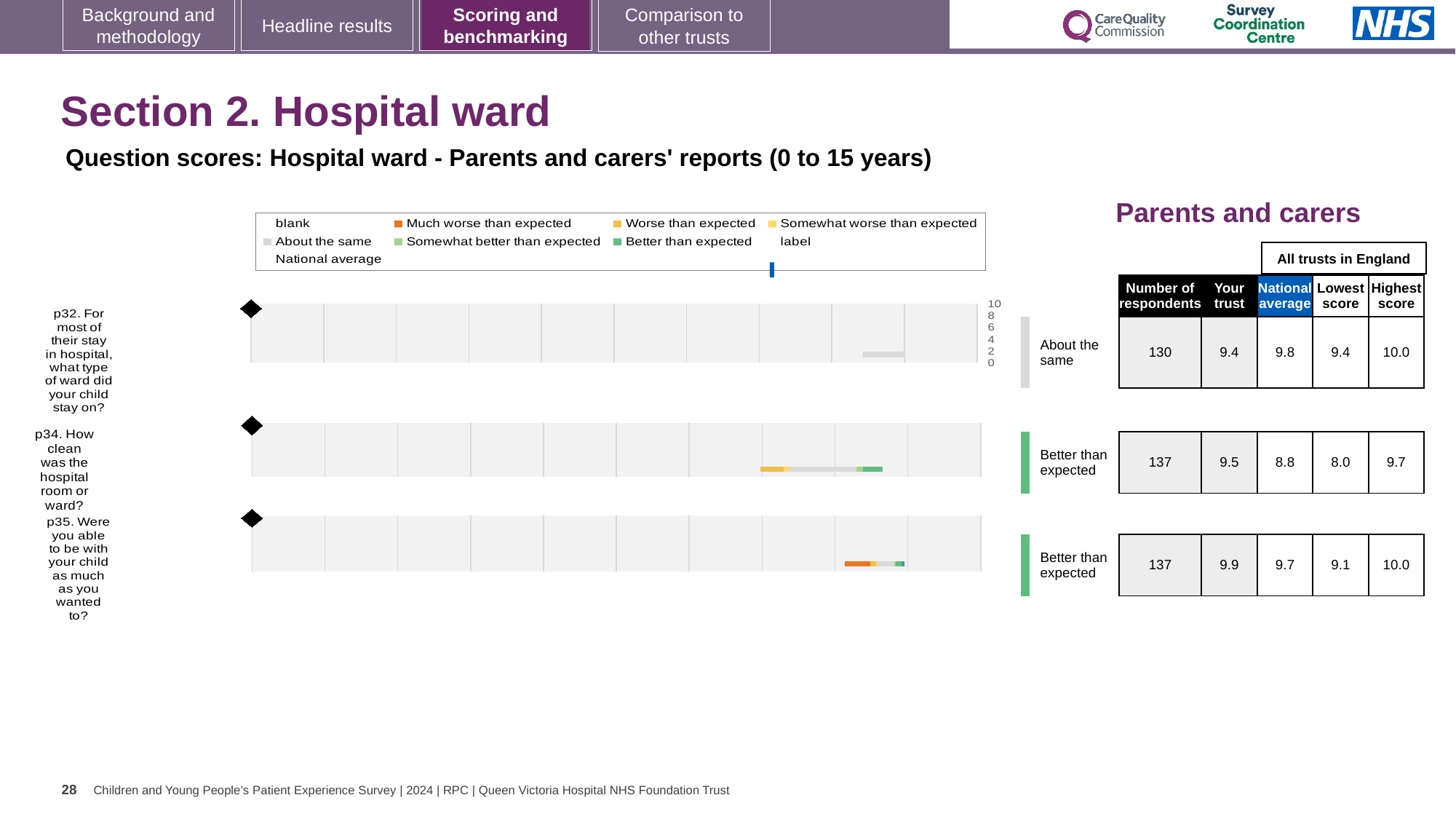
How many questions (p32, p34, p35) are plotted as separate bars on the slide? 3 How many entries does the chart legend list? 9 What is the difference between the 'Your trust' score and the national average for p34? 0.7 What is the highest value shown on the chart's score axis? 10 In the benchmark table, what is the national average for p34 (how clean was the hospital room or ward)? 8.8 In the benchmark table, what is the 'Your trust' score for p32 (what type of ward did your child stay on)? 9.4 Which of the three questions has the lowest national average in the benchmark table? p34 In the benchmark table, how many respondents answered p35 (were you able to be with your child as much as you wanted to)? 137 Is the 'Your trust' score for p32 larger or smaller than the national average for p32? smaller Which of the three questions has the highest 'Your trust' score in the benchmark table? p35 Which legend entry is shown in orange? Much worse than expected What kind of chart is used to show the question scores on this slide? bar chart